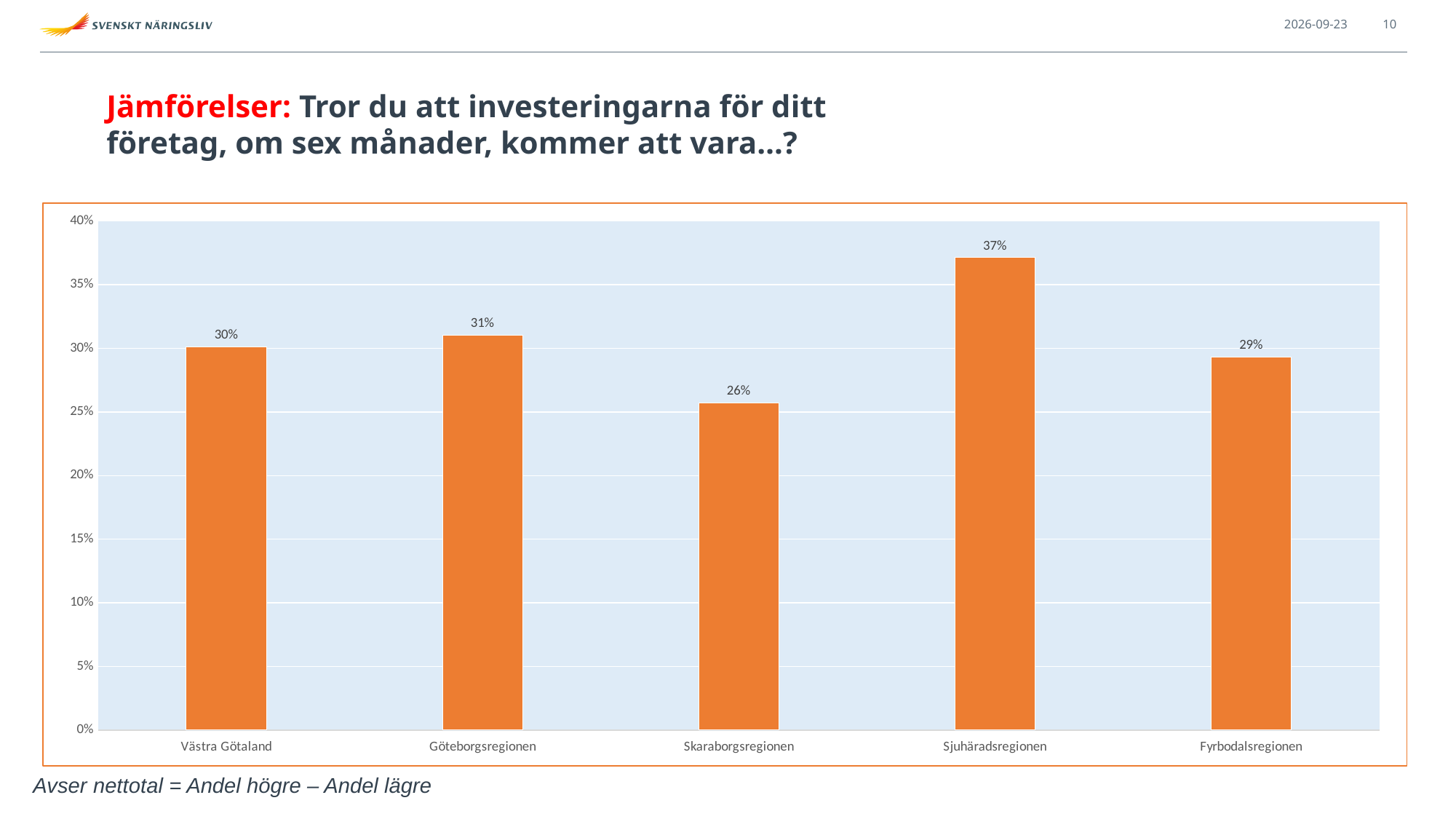
Which region has the lowest value? Skaraborgsregionen What is the value for Skaraborgsregionen? 26% How many regions are shown in the chart? 5 What is the value for Göteborgsregionen? 31% What is the value for Sjuhäradsregionen? 37% Is the value for Sjuhäradsregionen greater or less than 35%? greater Which region has the highest value? Sjuhäradsregionen What is the difference between the values for Sjuhäradsregionen and Skaraborgsregionen? 11% Which is larger, the value for Göteborgsregionen or the value for Fyrbodalsregionen? Göteborgsregionen What kind of chart is shown on the slide? Bar chart What is the value for Västra Götaland? 30% What is the value for Fyrbodalsregionen? 29%